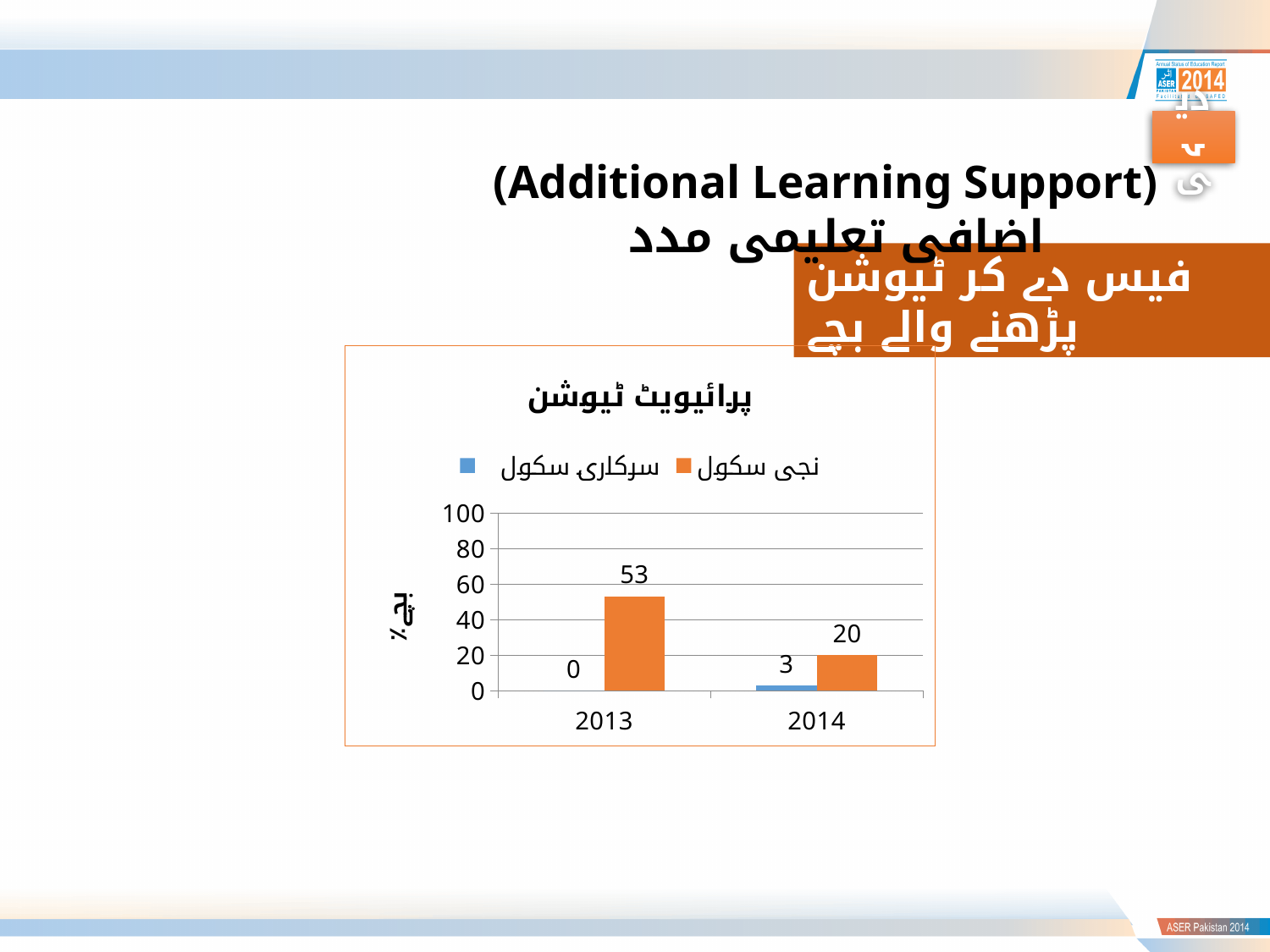
What is the difference between the نجی سکول and سرکاری سکول values in 2014? 17 Does the value for نجی سکول (private school) rise or fall from 2013 to 2014? fall What is the value for نجی سکول (private school) in 2013? 53 What is the value for سرکاری سکول (government school) in 2013? 0 Which year has the higher value for نجی سکول (private school)? 2013 What is the value for نجی سکول (private school) in 2014? 20 What is the value for سرکاری سکول (government school) in 2014? 3 What type of chart is shown on the slide? bar chart How many series does the legend list? 2 How many years are shown on the x axis? 2 What is the difference between the نجی سکول (private school) values for 2013 and 2014? 33 What is the title of the chart? پرائیویٹ ٹیوشن